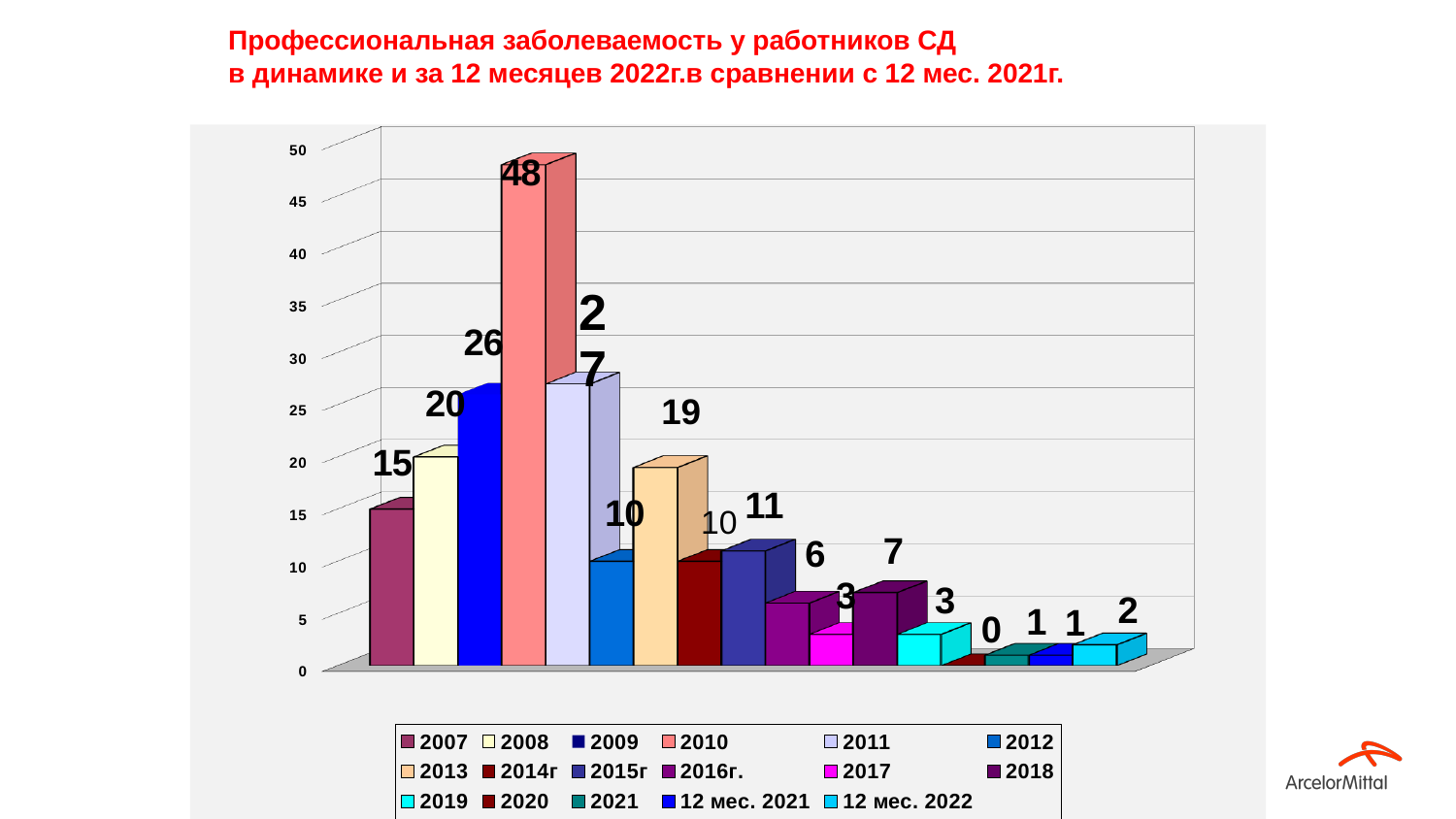
How many series does the legend list? 17 What is the value for 2013? 19 What is the value for 12 мес. 2022? 2 What is the value for 2007? 15 What is the difference between the values for 2010 and 2009? 22 What kind of chart is shown on the slide? bar chart Which series has the lowest value? 2020 Which is larger, the value for 2009 or the value for 2013? 2009 Which year has the highest value? 2010 What is the value for 2020? 0 What is the difference between the values for 2008 and 2007? 5 What is the value for 2010? 48